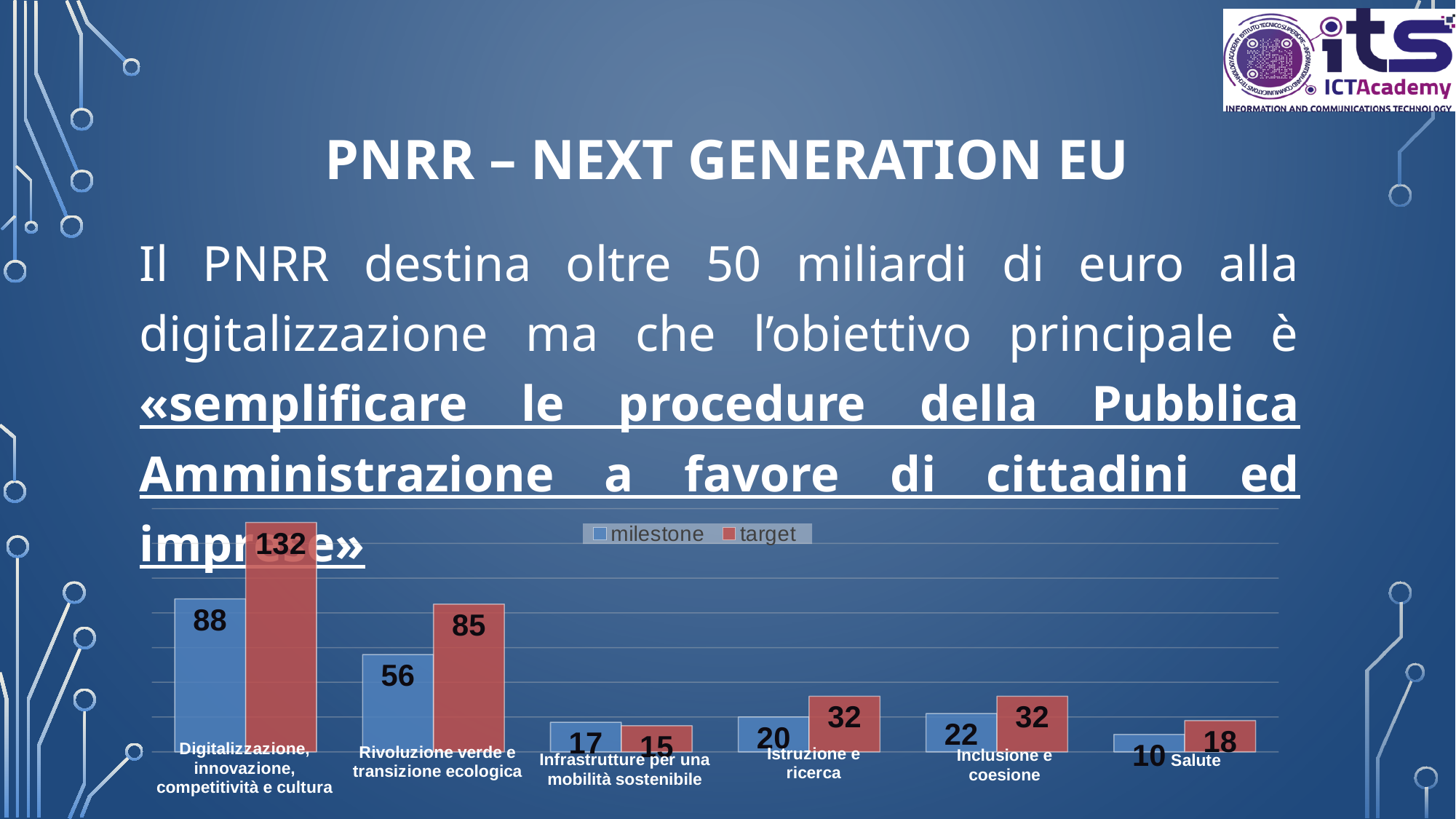
Which category has the lowest milestone value? Salute What is the target value for Salute? 18 What is the target value for Rivoluzione verde e transizione ecologica? 85 What is the milestone value for Inclusione e coesione? 22 How many series does the chart legend list? 2 How many categories are shown on the x axis of the chart? 6 What is the milestone value for Digitalizzazione, innovazione, competitività e cultura? 88 What is the difference between the target and milestone values for Digitalizzazione, innovazione, competitività e cultura? 44 Which series is shown in red in the chart? target What kind of chart is shown on the slide? bar chart Which is larger for Infrastrutture per una mobilità sostenibile, the milestone value or the target value? milestone Which category has the highest target value? Digitalizzazione, innovazione, competitività e cultura